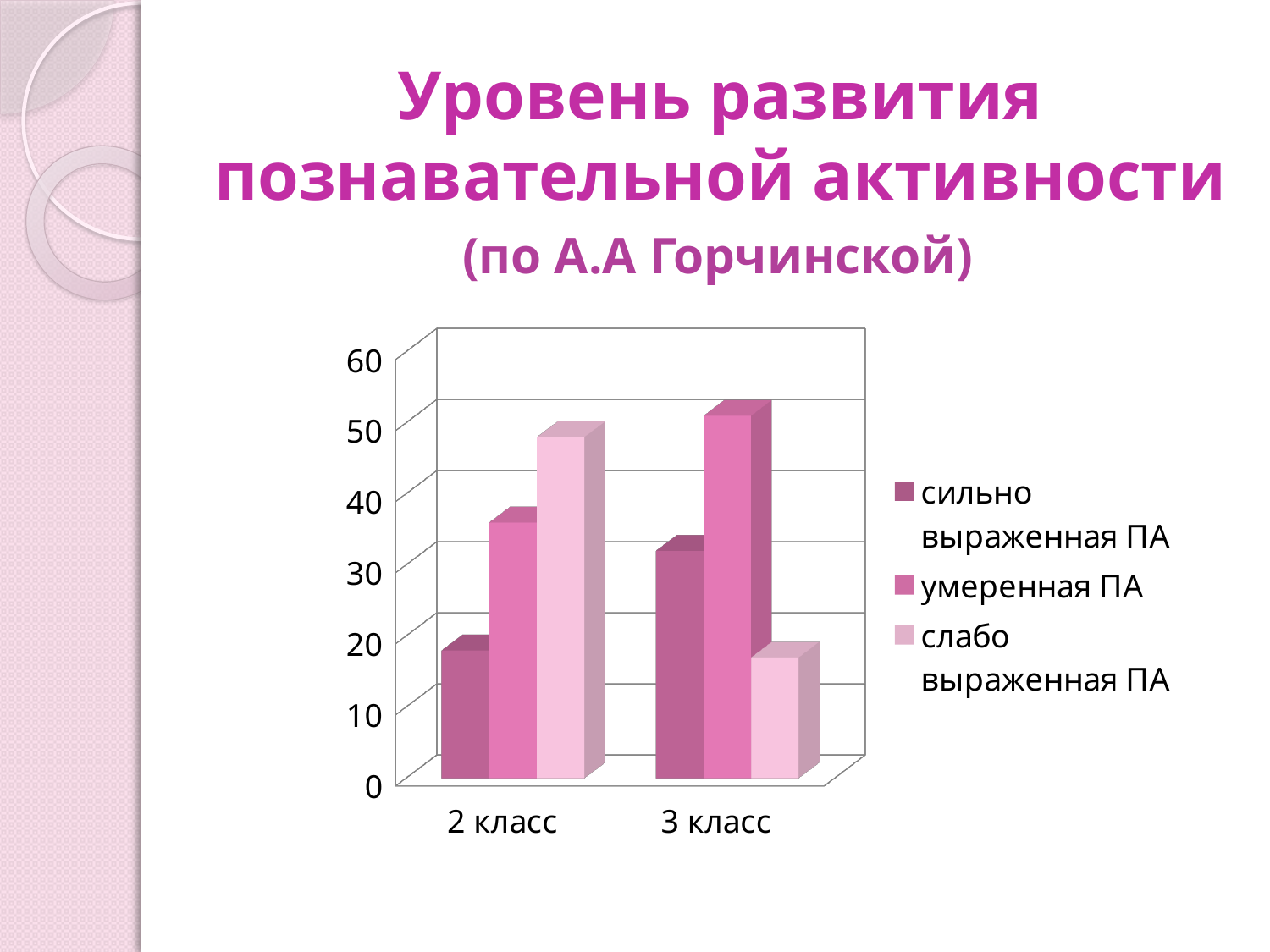
Which is larger: слабо выраженная ПА for 2 класс or for 3 класс? 2 класс Which series has the highest bar for 3 класс? умеренная ПА How many categories are shown on the x axis of the chart? 2 Is the value for слабо выраженная ПА in 2 класс greater or less than 40? greater Which is larger: сильно выраженная ПА for 2 класс or for 3 класс? 3 класс Which series has the lowest bar for 3 класс? слабо выраженная ПА Which series has the highest bar for 2 класс? слабо выраженная ПА Which series has the lowest bar for 2 класс? сильно выраженная ПА Is the value for сильно выраженная ПА in 2 класс greater or less than 20? less Is the value for умеренная ПА in 3 класс greater or less than 40? greater How many series does the legend list? 3 What kind of chart is shown on the slide? bar chart